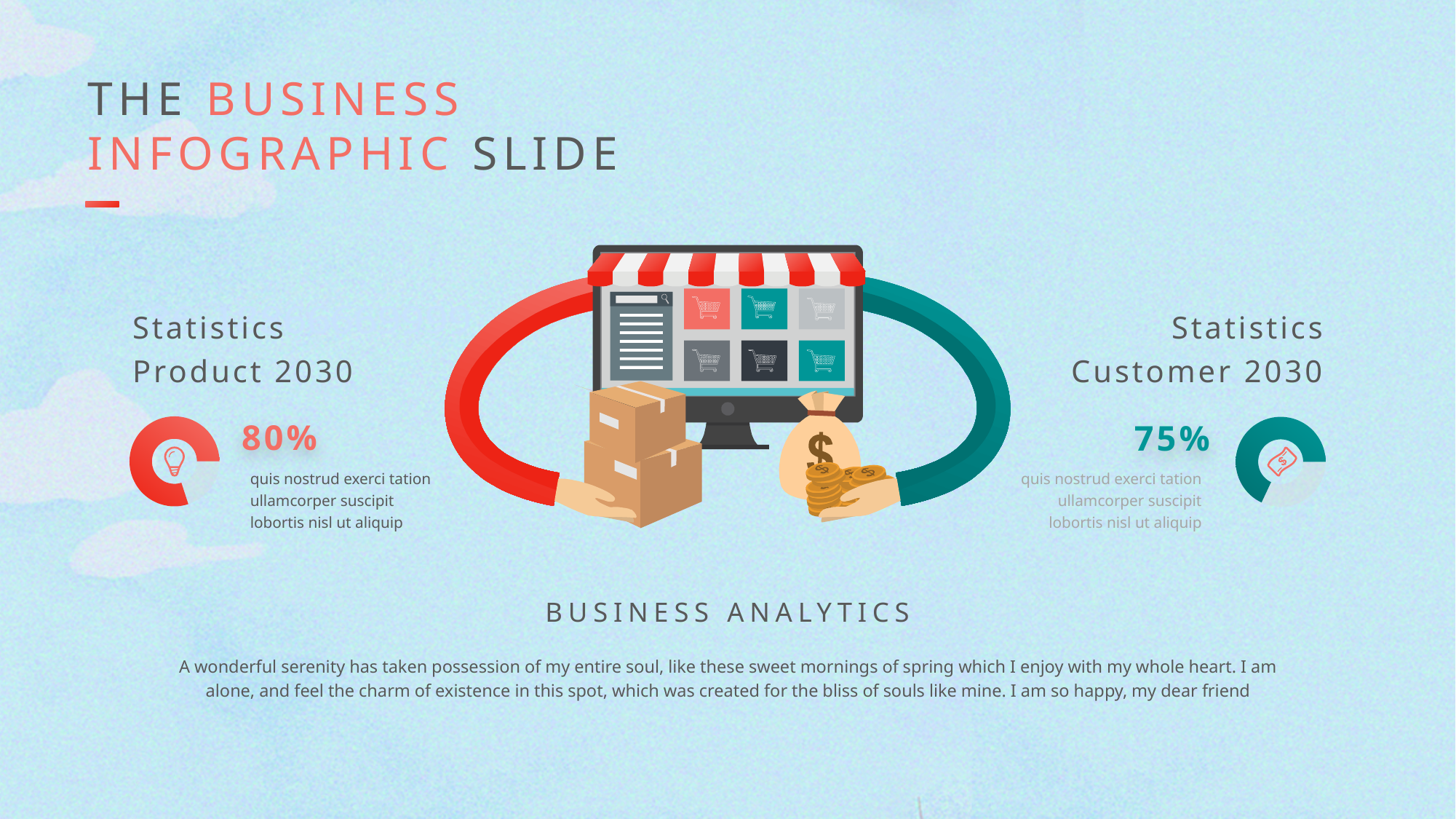
How many donut charts are on the slide? 2 Which of the two statistics shows the lowest percentage? Statistics Customer 2030 Which of the two statistics shows the highest percentage? Statistics Product 2030 What is the difference in percentage points between Statistics Product 2030 and Statistics Customer 2030? 5 What percentage is shown for Statistics Customer 2030? 75% What kind of chart is used to show the Statistics Product 2030 value? Donut chart Is the value for Statistics Customer 2030 greater or less than 50%? greater What percentage is shown for Statistics Product 2030? 80% What colour is the donut chart for Statistics Product 2030? Red Which statistic has the higher percentage, Product 2030 or Customer 2030? Product 2030 What colour is the donut chart for Statistics Customer 2030? Teal